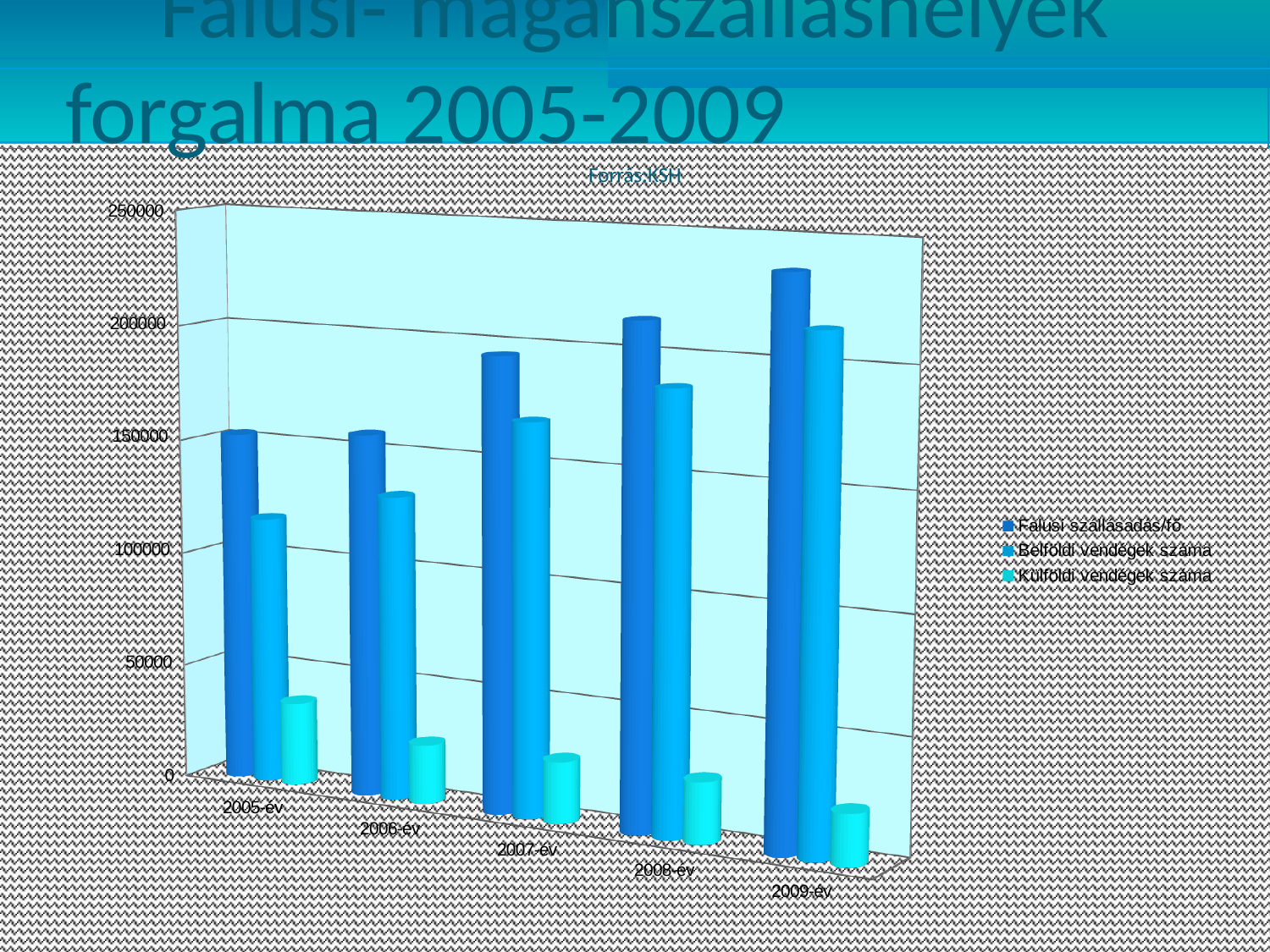
How many series does the legend list? 3 Does the value for Külföldi vendégek száma rise or fall from 2005.év to 2009.év? fall Is the value for Falusi szállásadás/fő in 2009.év greater or less than 200000? greater Which year has the highest value for Falusi szállásadás/fő? 2009-év Is the value for Belföldi vendégek száma in 2008.év greater or less than 150000? greater Which year has the lowest value for Külföldi vendégek száma? 2009-év How many year categories are shown on the x axis? 5 What is the title printed above the chart? Forrás:KSH In 2005.év, which is larger: Falusi szállásadás/fő or Belföldi vendégek száma? Falusi szállásadás/fő Is the value for Külföldi vendégek száma in 2005.év greater or less than 50000? less What kind of chart is shown on the slide? bar chart Does the value for Falusi szállásadás/fő rise or fall from 2005.év to 2009.év? rise